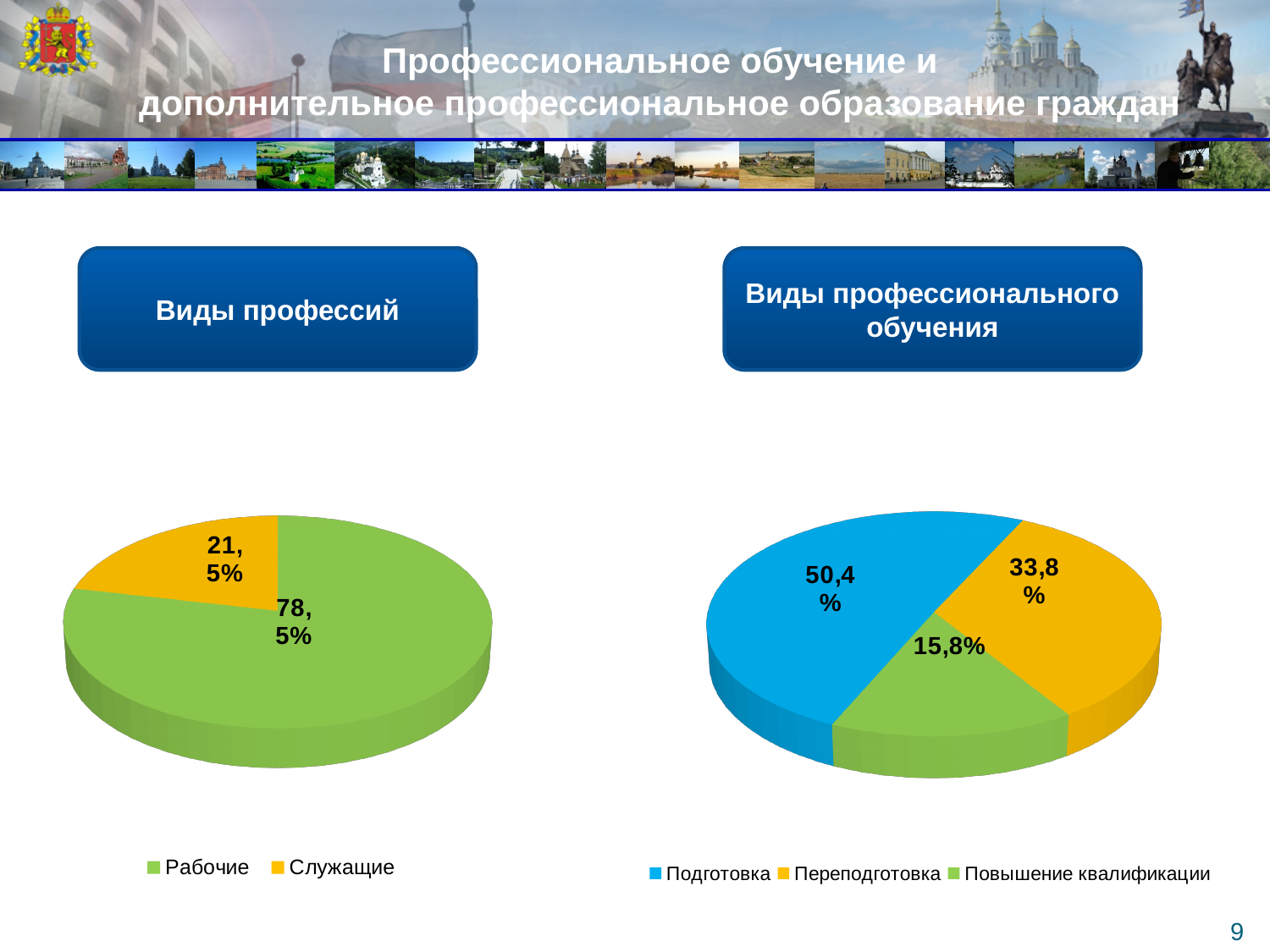
In the 'Виды профессионального обучения' chart, which is larger: Подготовка or Переподготовка? Подготовка In the 'Виды профессий' chart, what is the difference between the shares of Рабочие and Служащие? 57 percentage points In the 'Виды профессий' chart, which category has the largest share? Рабочие In the 'Виды профессий' chart, what share is shown for Служащие? 21,5% How many slices does the 'Виды профессионального обучения' pie chart have? 3 In the 'Виды профессионального обучения' chart, what share is shown for Повышение квалификации? 15,8% In the 'Виды профессий' chart, what share is shown for Рабочие? 78,5% In the 'Виды профессионального обучения' chart, what share is shown for Подготовка? 50,4% How many categories does the legend of the 'Виды профессий' chart list? 2 What type of chart is used for 'Виды профессий'? Pie chart In the 'Виды профессионального обучения' chart, which category has the smallest share? Повышение квалификации In the 'Виды профессионального обучения' chart, what share is shown for Переподготовка? 33,8%